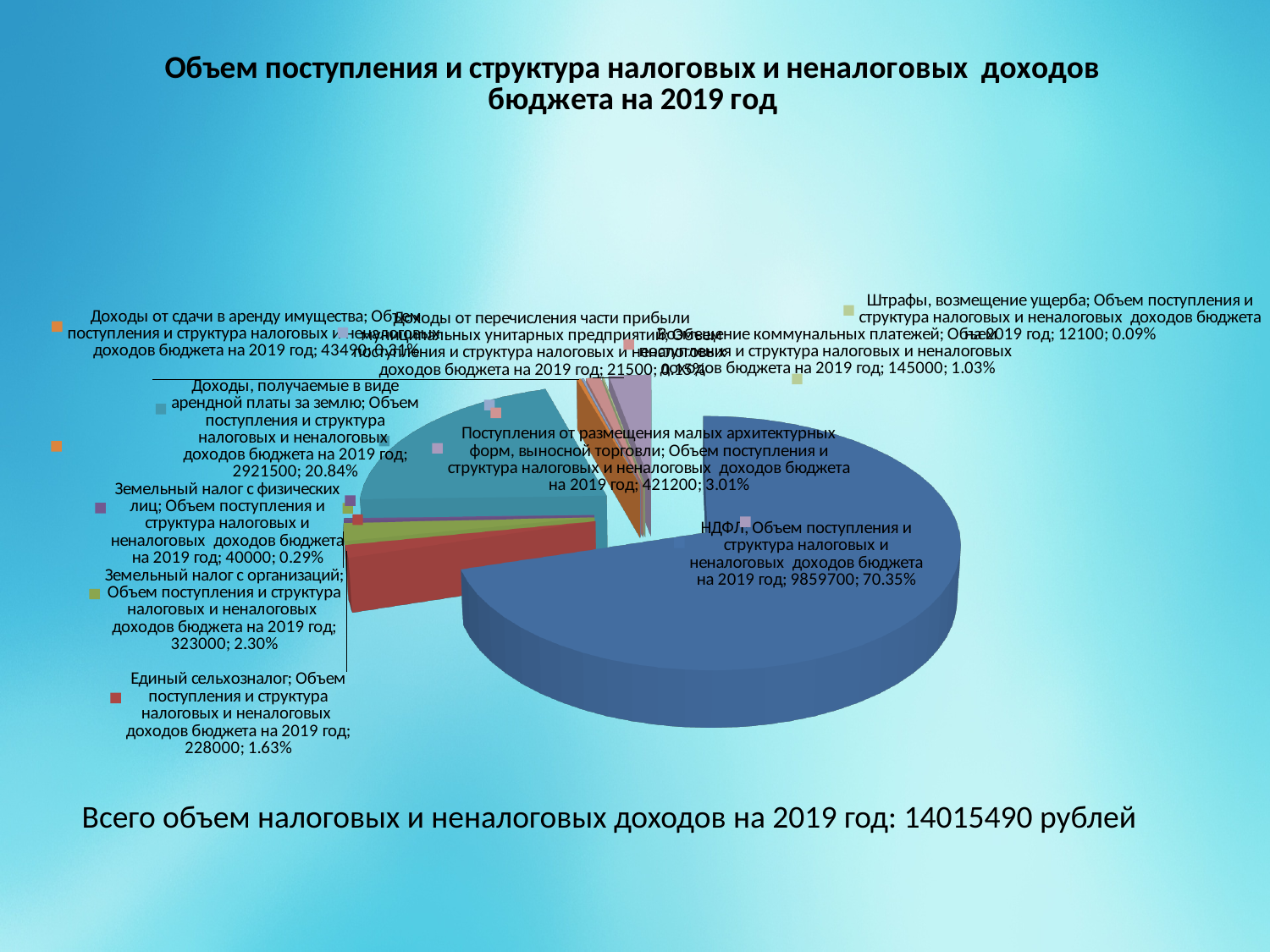
What is the difference between the values for Земельный налог с организаций and Единый сельхозналог? 95000 Which category has the largest share of the pie? НДФЛ What share of the pie does Земельный налог с организаций represent? 2.30% What is the value for НДФЛ? 9859700 What kind of chart is shown on the slide? pie chart What is the value for Единый сельхозналог? 228000 Which category has the smallest share of the pie? Штрафы, возмещение ущерба Which is larger: Возмещение коммунальных платежей or Земельный налог с физических лиц? Возмещение коммунальных платежей What is the value for Поступления от размещения малых архитектурных форм, выносной торговли? 421200 What share of the pie does НДФЛ represent? 70.35% What is the value for Доходы, получаемые в виде арендной платы за землю? 2921500 What is the total volume of tax and non-tax revenues for 2019 stated on the slide? 14015490 рублей